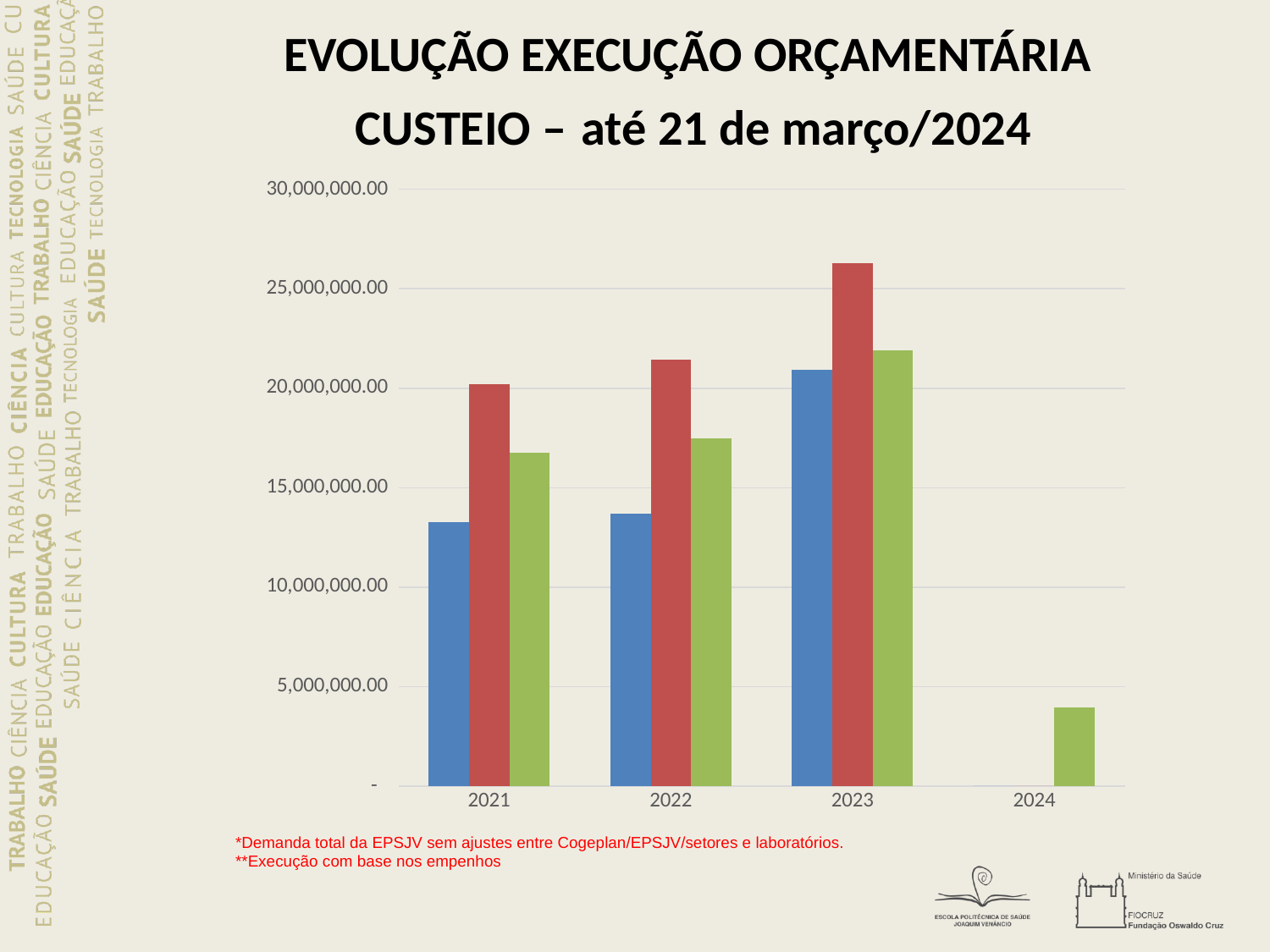
What kind of chart is shown on the slide? bar chart Do the red bars rise or fall from 2021 to 2023? rise How many differently coloured bars are plotted for the year 2023? 3 Is the value of the green bar for 2024 greater or less than 5,000,000.00? less Is the value of the green bar for 2023 greater or less than 20,000,000.00? greater Is the value of the blue bar for 2021 greater or less than 15,000,000.00? less In which year is the green bar the shortest? 2024 In which year is the red bar the tallest? 2023 How many years are shown on the x axis of the chart? 4 For 2022, which bar is taller, the red bar or the green bar? red